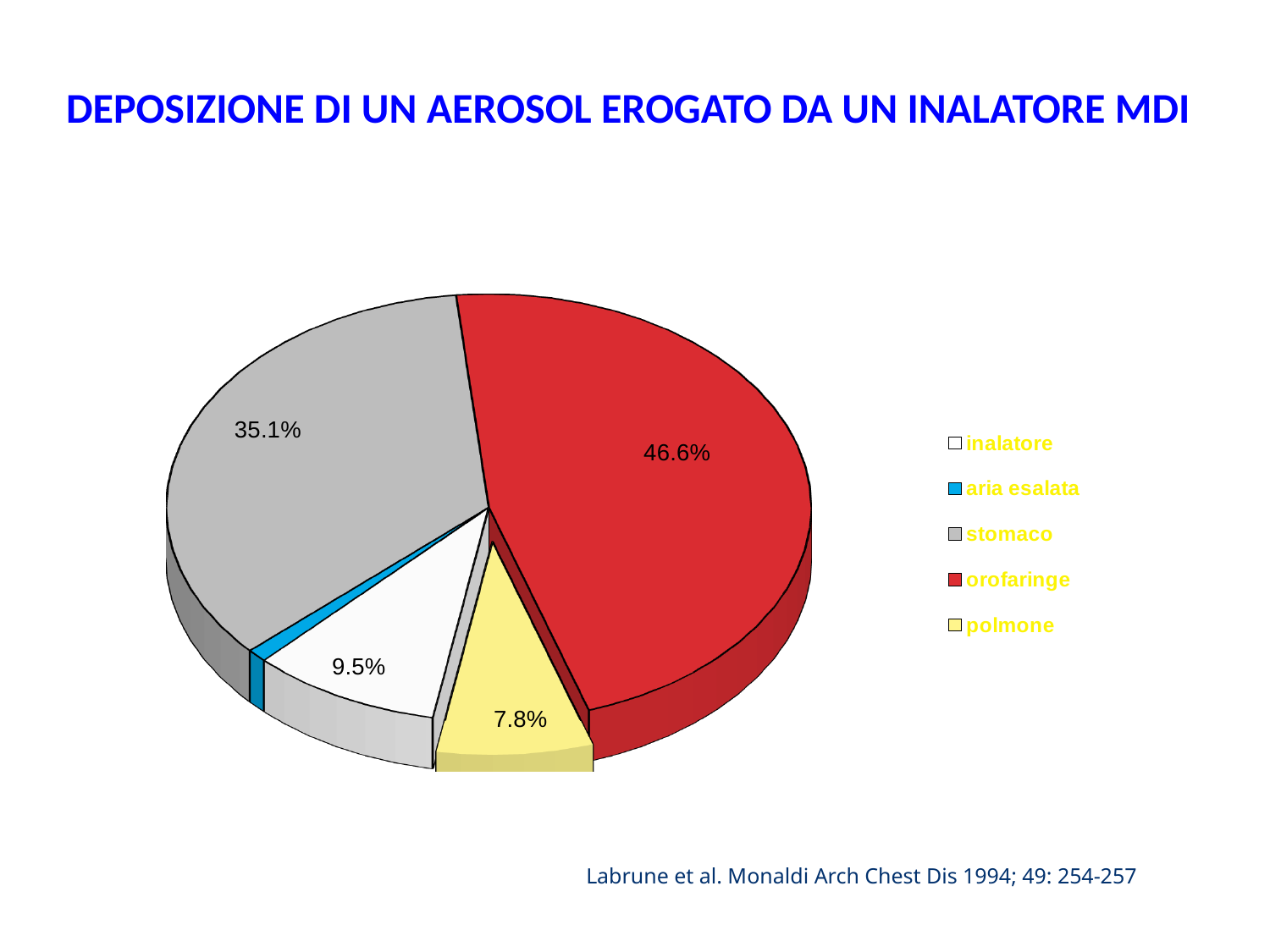
What is the difference in percentage points between the orofaringe slice and the stomaco slice? 11.5 What kind of chart is shown on the slide? pie chart What share of the pie is labelled for inalatore? 9.5% What share of the pie is labelled for orofaringe? 46.6% What is the difference in percentage points between the inalatore slice and the polmone slice? 1.7 Which category has the largest slice of the pie? orofaringe Which category has the smallest slice of the pie? aria esalata What colour is the slice for orofaringe? red Which slice is larger, stomaco or polmone? stomaco What share of the pie is labelled for stomaco? 35.1% What share of the pie is labelled for polmone? 7.8% How many categories does the legend list? 5